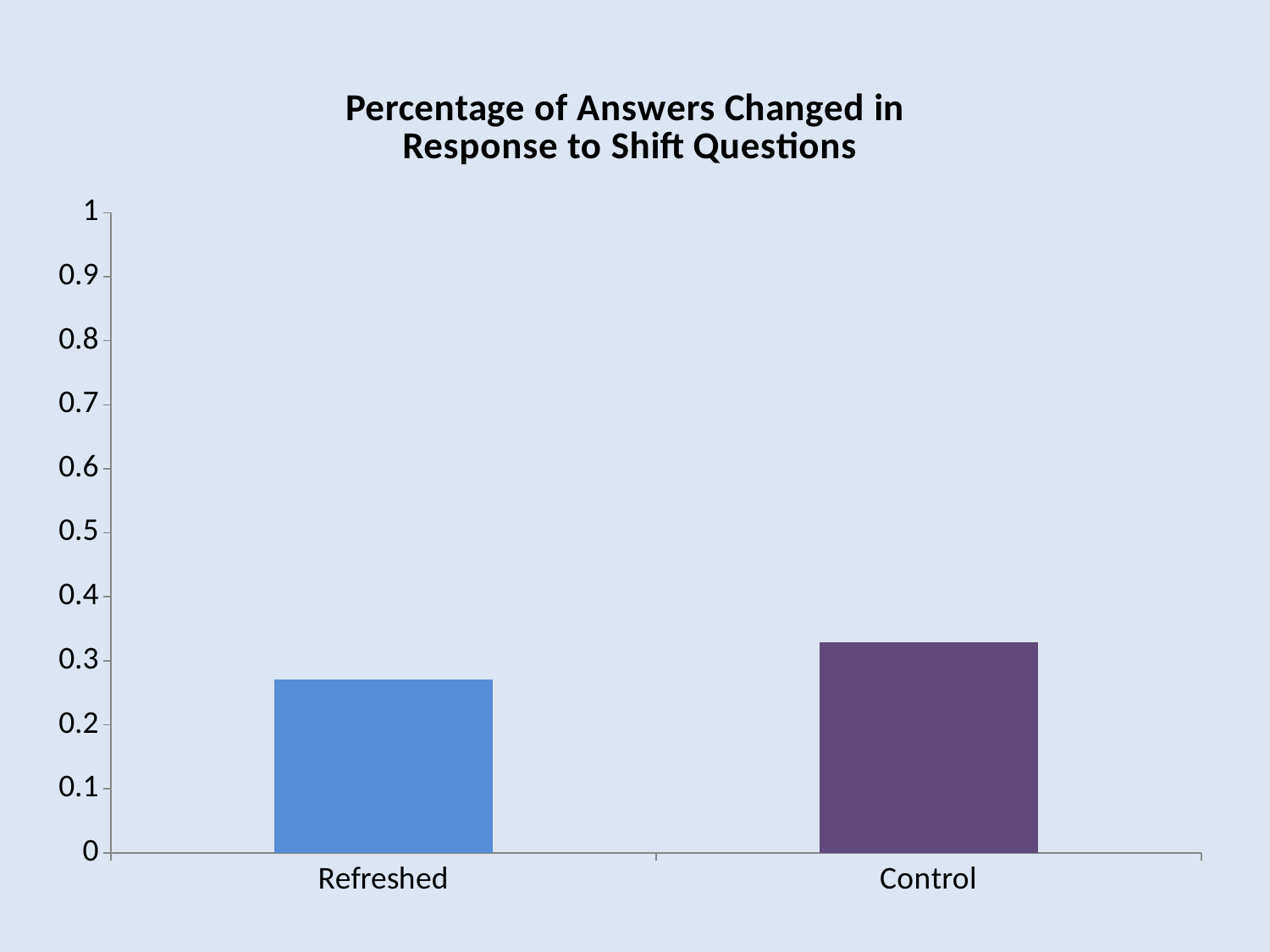
What is the maximum value shown on the y axis? 1 How many categories are shown on the x axis? 2 Is the value for Control greater or less than 0.3? greater Is the value for Refreshed greater or less than 0.3? less What kind of chart is shown on the slide? bar chart Which category has the lowest value? Refreshed What is the title of the chart? Percentage of Answers Changed in Response to Shift Questions Is the value for Control greater or less than 0.4? less Which category has the highest value? Control Which is larger, the value for Refreshed or the value for Control? Control